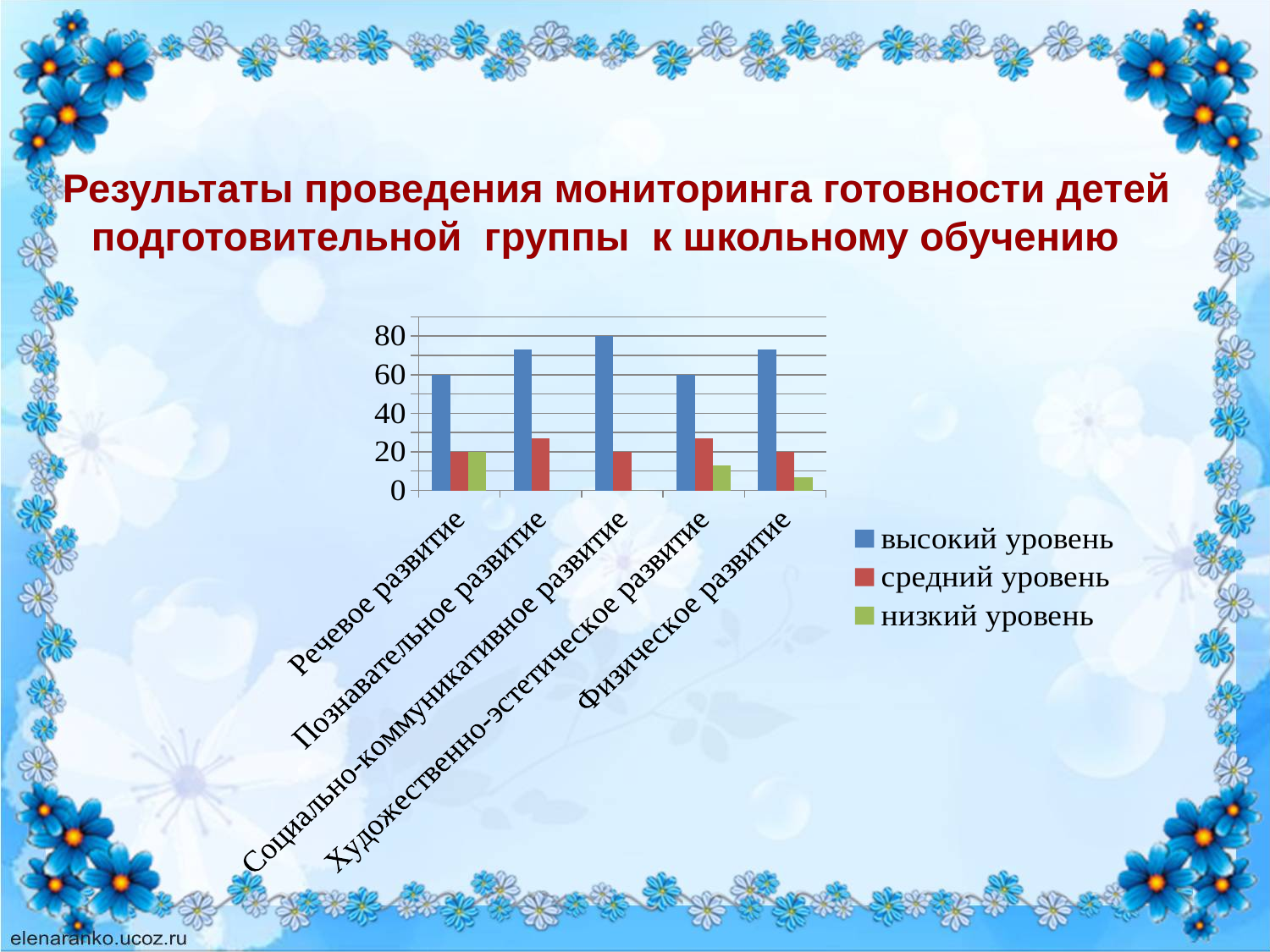
Is the value of 'средний уровень' for 'Художественно-эстетическое развитие' greater or less than 20? greater Which series is shown in blue in the chart? высокий уровень Is the value of 'высокий уровень' for 'Познавательное развитие' greater or less than 60? greater How many categories are shown on the x axis of the chart? 5 Is the value of 'низкий уровень' for 'Физическое развитие' greater or less than 20? less What is the value of 'высокий уровень' for 'Социально-коммуникативное развитие'? 80 For 'Физическое развитие', which is larger: 'высокий уровень' or 'средний уровень'? высокий уровень Which category has the highest value for the series 'высокий уровень'? Социально-коммуникативное развитие Which series is shown in green in the chart? низкий уровень What is the value of 'высокий уровень' for 'Речевое развитие'? 60 What kind of chart is shown on the slide? bar chart How many series does the chart legend list? 3